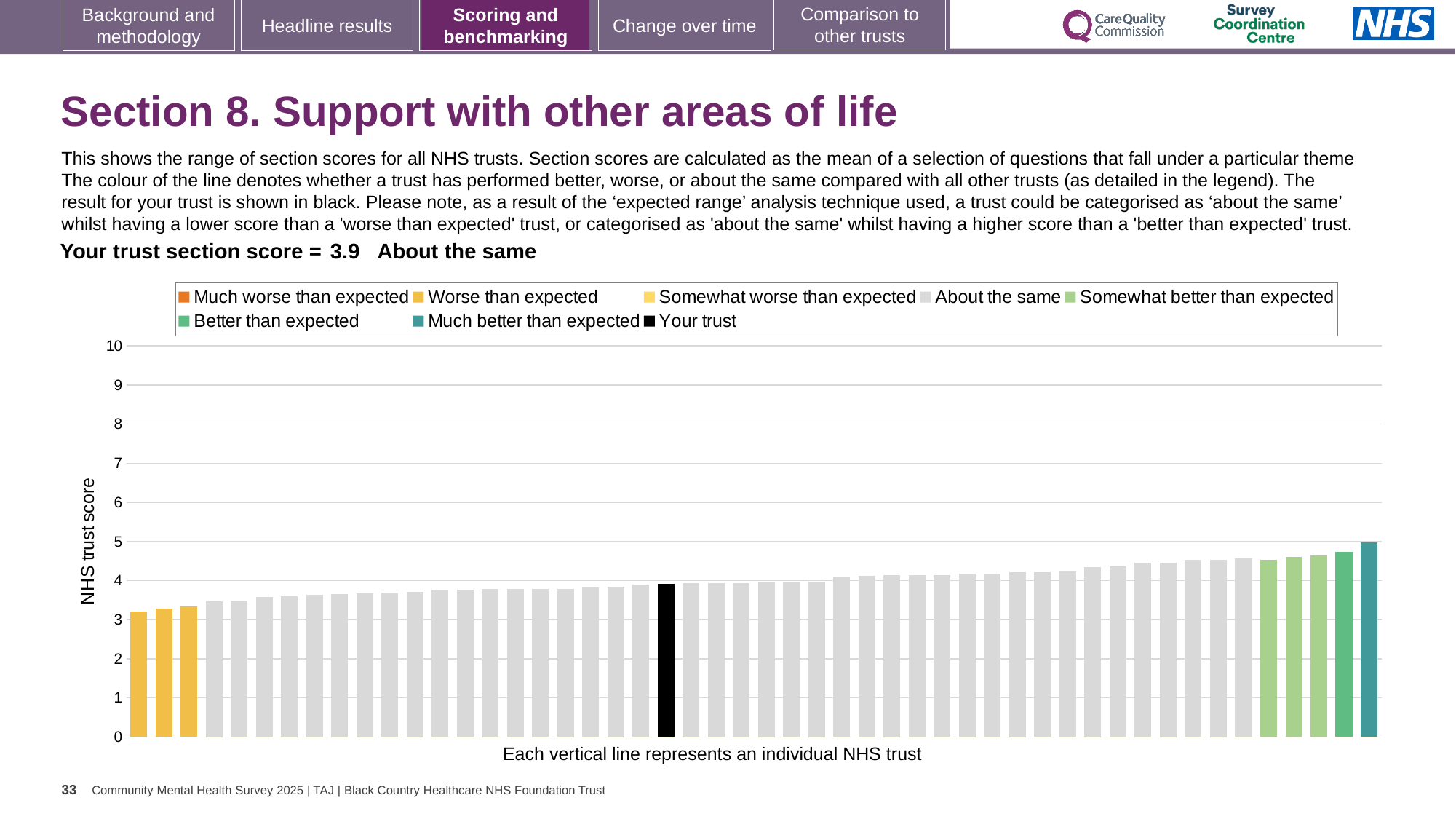
Is the value of the lowest bar in the chart greater or less than 3? greater Which legend category does the tallest bar in the chart belong to? Much better than expected How many bars are coloured as 'Worse than expected' (yellow)? 3 Is the value of the black 'Your trust' bar greater or less than 5? less What kind of chart is shown on the slide? Bar chart How many entries does the chart legend list? 8 What is the label on the vertical axis of the chart? NHS trust score Is the value of the tallest bar in the chart greater or less than 4? greater Which category is your trust's section score placed in? About the same What is the section score for your trust shown on the slide? 3.9 Do the bar values rise or fall from left to right along the x axis? Rise How many bars are coloured as 'Much better than expected' (teal)? 1